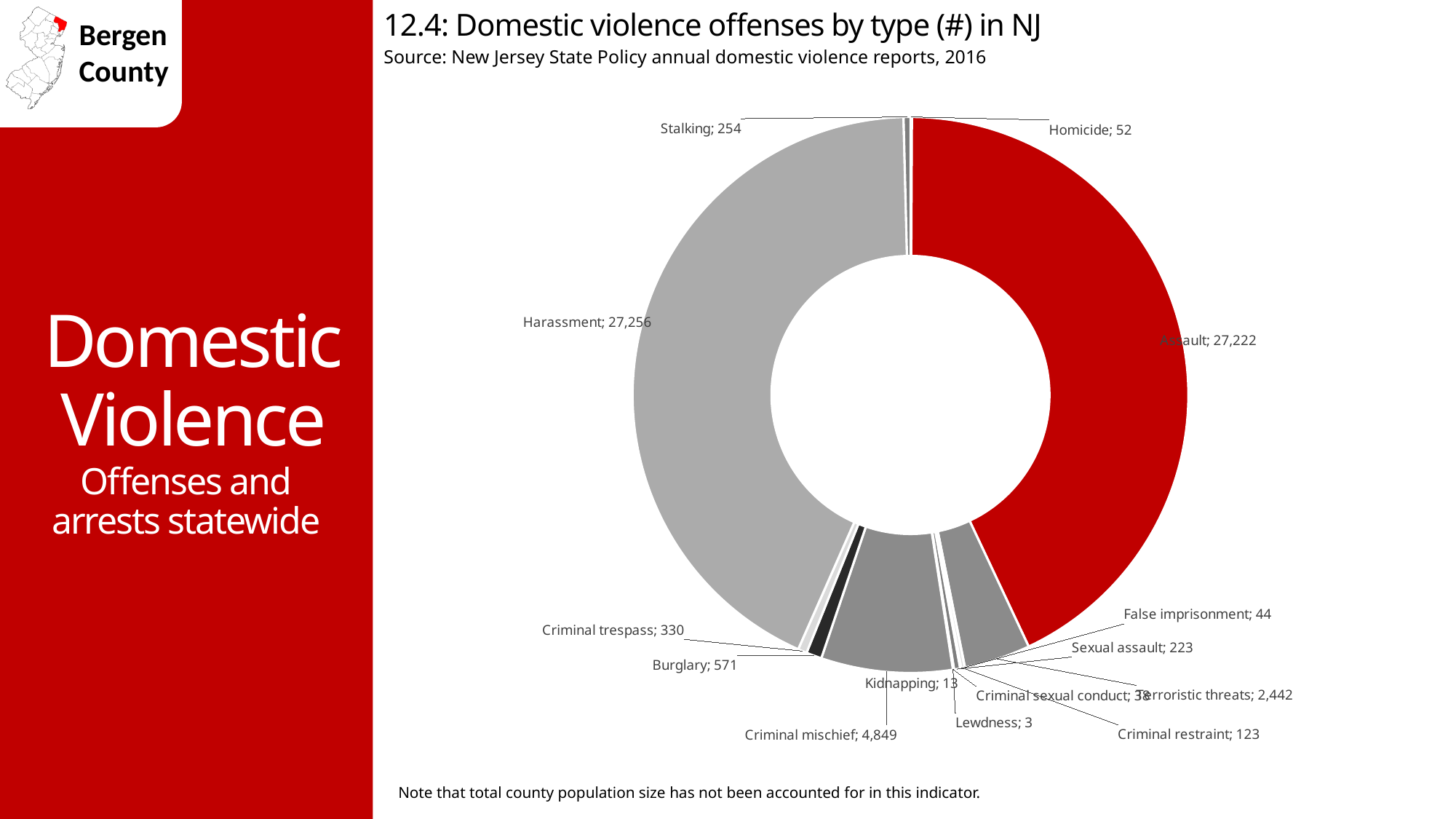
What is the number of Harassment offenses shown in the chart? 27,256 What is the difference between the Burglary and Criminal trespass values? 241 What value is shown for Homicide? 52 What is the number of Assault offenses shown in the chart? 27,222 What kind of chart is shown on the slide? doughnut chart Which offense type has the highest number in the chart? Harassment What value is shown for Criminal mischief? 4,849 Which offense type has the lowest number in the chart? Lewdness What is the difference between the Harassment and Assault values? 34 How many offense types are shown in the chart? 14 Which is larger, Stalking or Sexual assault? Stalking How many Terroristic threats offenses are shown in the chart? 2,442